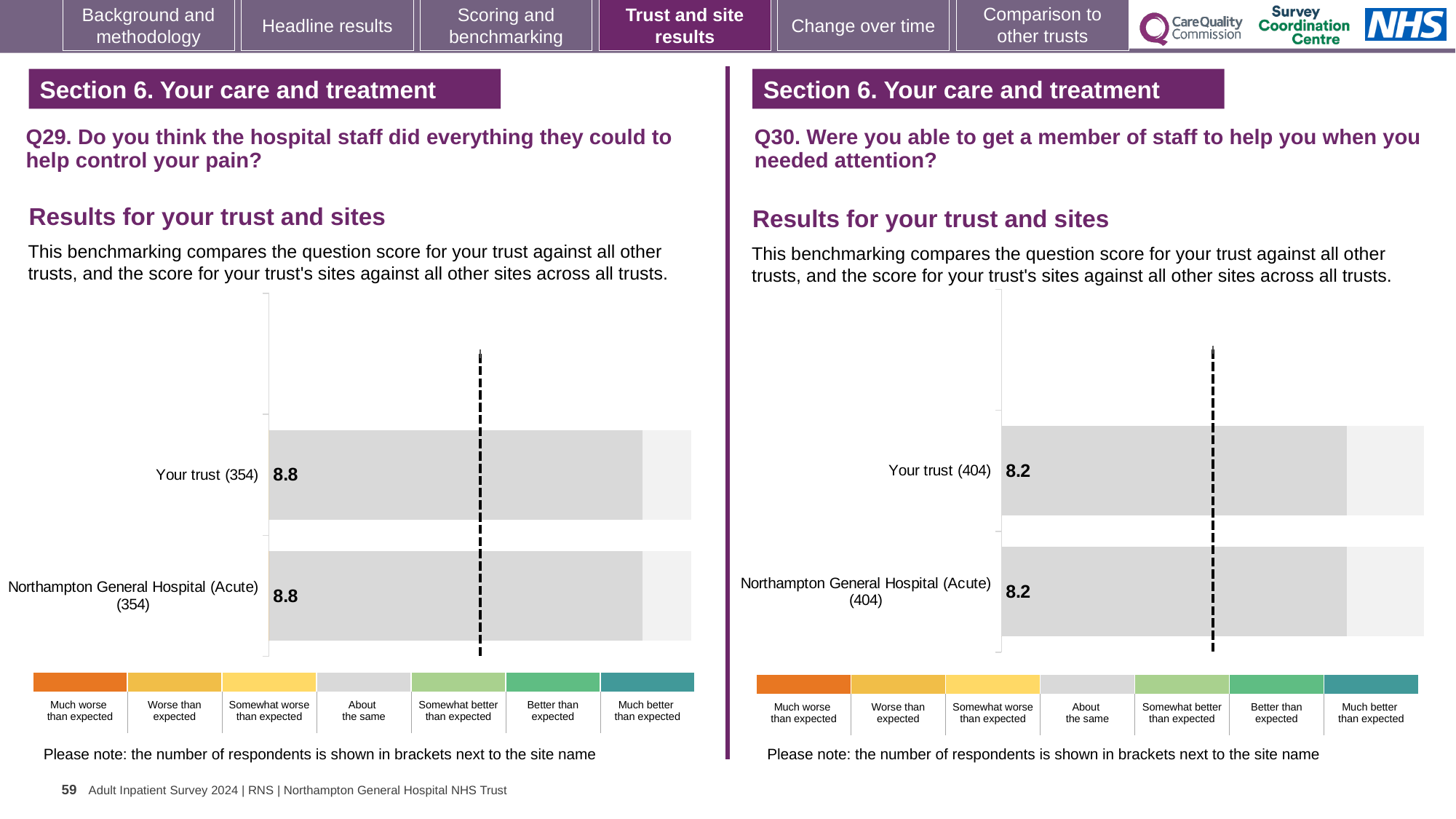
How many bars are plotted on the Q29 chart (left)? 2 On the Q29 chart (left), what is the score for Northampton General Hospital (Acute)? 8.8 How many bars are plotted on the Q30 chart (right)? 2 On the Q30 chart (right), how many respondents are shown in brackets next to Northampton General Hospital (Acute)? 404 On the Q30 chart (right), what is the score for Your trust? 8.2 On the Q30 chart (right), what is the score for Northampton General Hospital (Acute)? 8.2 On the Q29 chart (left), how many respondents are shown in brackets next to Your trust? 354 On the Q30 chart (right), what is the difference between the score for Your trust and the score for Northampton General Hospital (Acute)? 0.0 On the Q29 chart (left), what is the score for Your trust? 8.8 On the Q29 chart (left), what is the difference between the score for Your trust and the score for Northampton General Hospital (Acute)? 0.0 What kind of chart is the Q29 chart (left)? Bar chart Is the score for Your trust on the Q29 chart (left) larger or smaller than the score for Your trust on the Q30 chart (right)? Larger